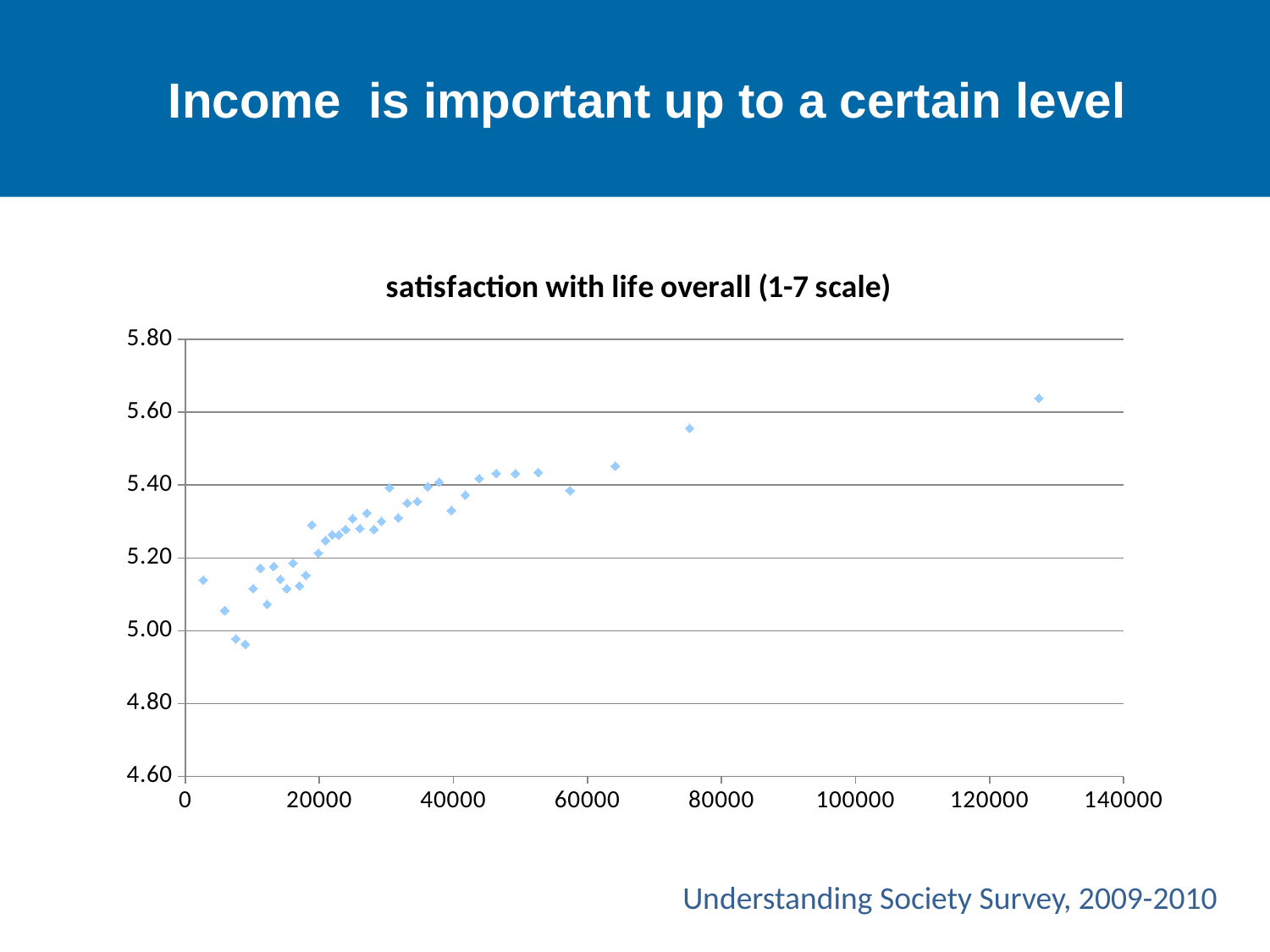
Which has the higher satisfaction value: the point at roughly 127000 income or the point at roughly 75000 income? the point at roughly 127000 income Are the satisfaction values for the points at roughly 8000-9000 income greater or less than 5.00? less Is the satisfaction value for the point at roughly 75000 income greater or less than 5.60? less What is the title of the chart? satisfaction with life overall (1-7 scale) Is the satisfaction value for the point at roughly 64000 income greater or less than 5.40? greater Which has the lower satisfaction value: the point at roughly 8000 income or the point at roughly 20000 income? the point at roughly 8000 income What kind of chart is shown on the slide? scatter chart What is the highest value shown on the x axis? 140000 Do the satisfaction values generally rise or fall as income increases along the x axis? rise